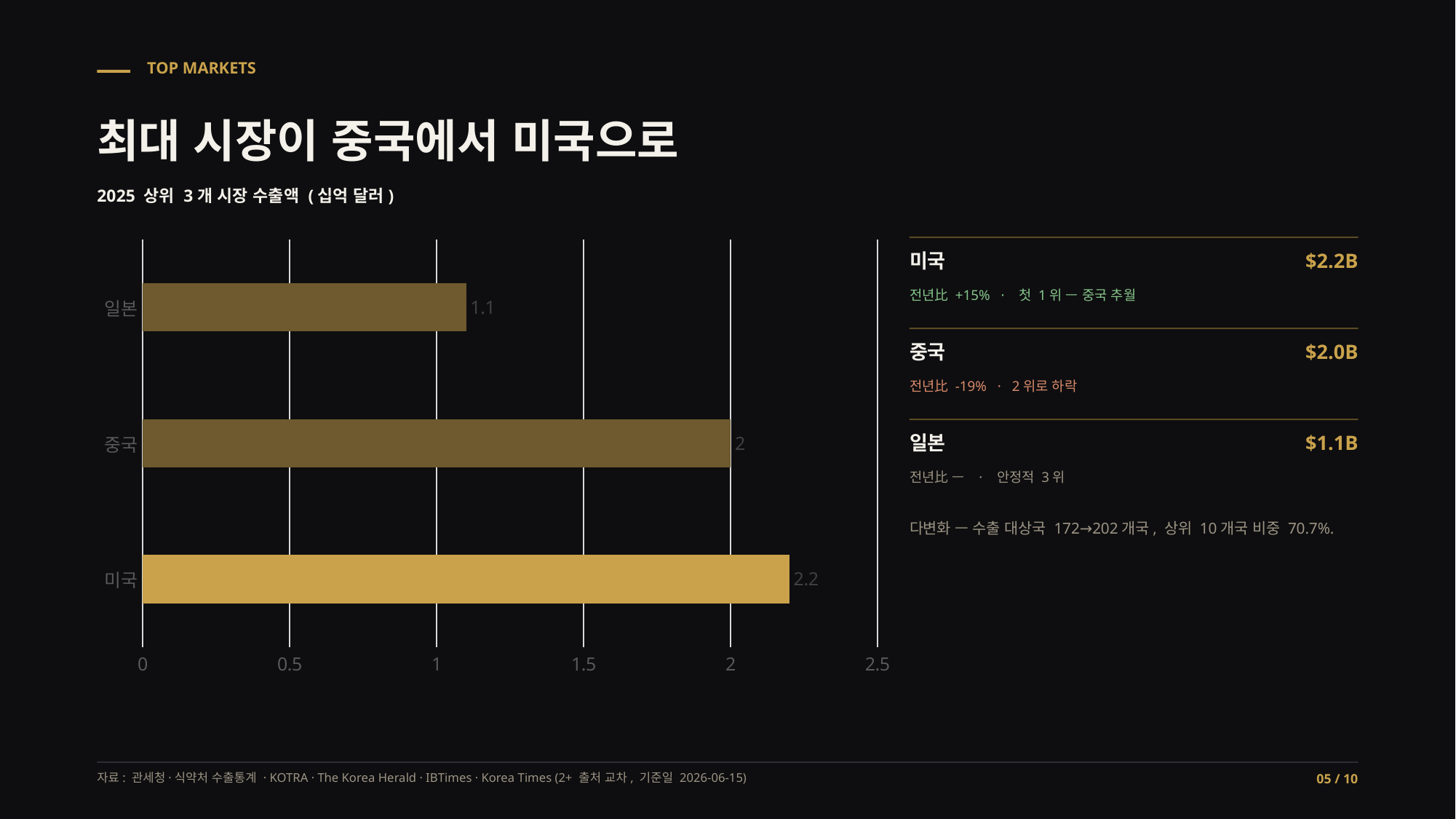
How many categories are shown in the bar chart? 3 What is the value for 중국 in the bar chart? 2 What is the subtitle describing the chart's data? 2025 상위 3개 시장 수출액 (십억 달러) Which category has the lowest value in the bar chart? 일본 Is the value for 일본 greater or less than 1.5? less What is the difference between the values for 미국 and 중국? 0.2 What is the difference between the values for 미국 and 일본? 1.1 What kind of chart is shown on the slide? bar chart What is the value for 미국 in the bar chart? 2.2 Which category has the highest value in the bar chart? 미국 What is the value for 일본 in the bar chart? 1.1 Which is larger, the value for 중국 or the value for 일본? 중국